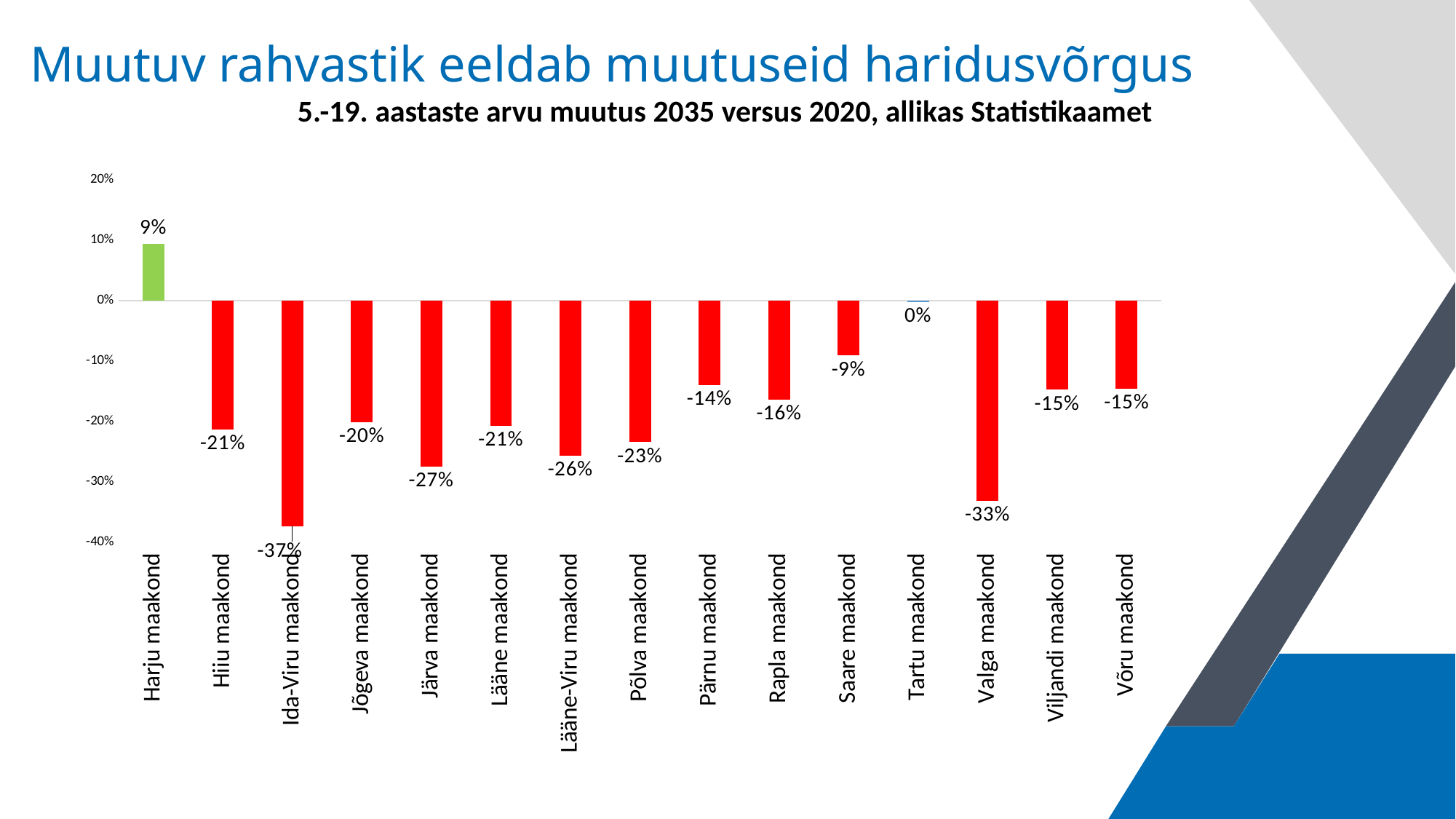
What is the chart's title? 5.-19. aastaste arvu muutus 2035 versus 2020, allikas Statistikaamet How many counties are shown on the x axis? 15 What is the value for Tartu maakond? 0% What is the value for Harju maakond? 9% What is the difference between the values for Harju maakond and Ida-Viru maakond? 46 percentage points Which county has the lowest value? Ida-Viru maakond Which has a larger value, Saare maakond or Pärnu maakond? Saare maakond What kind of chart is shown on the slide? Bar chart What is the value for Ida-Viru maakond? -37% What is the value for Valga maakond? -33% What colour is the bar for Harju maakond? Green Which county has the highest value? Harju maakond